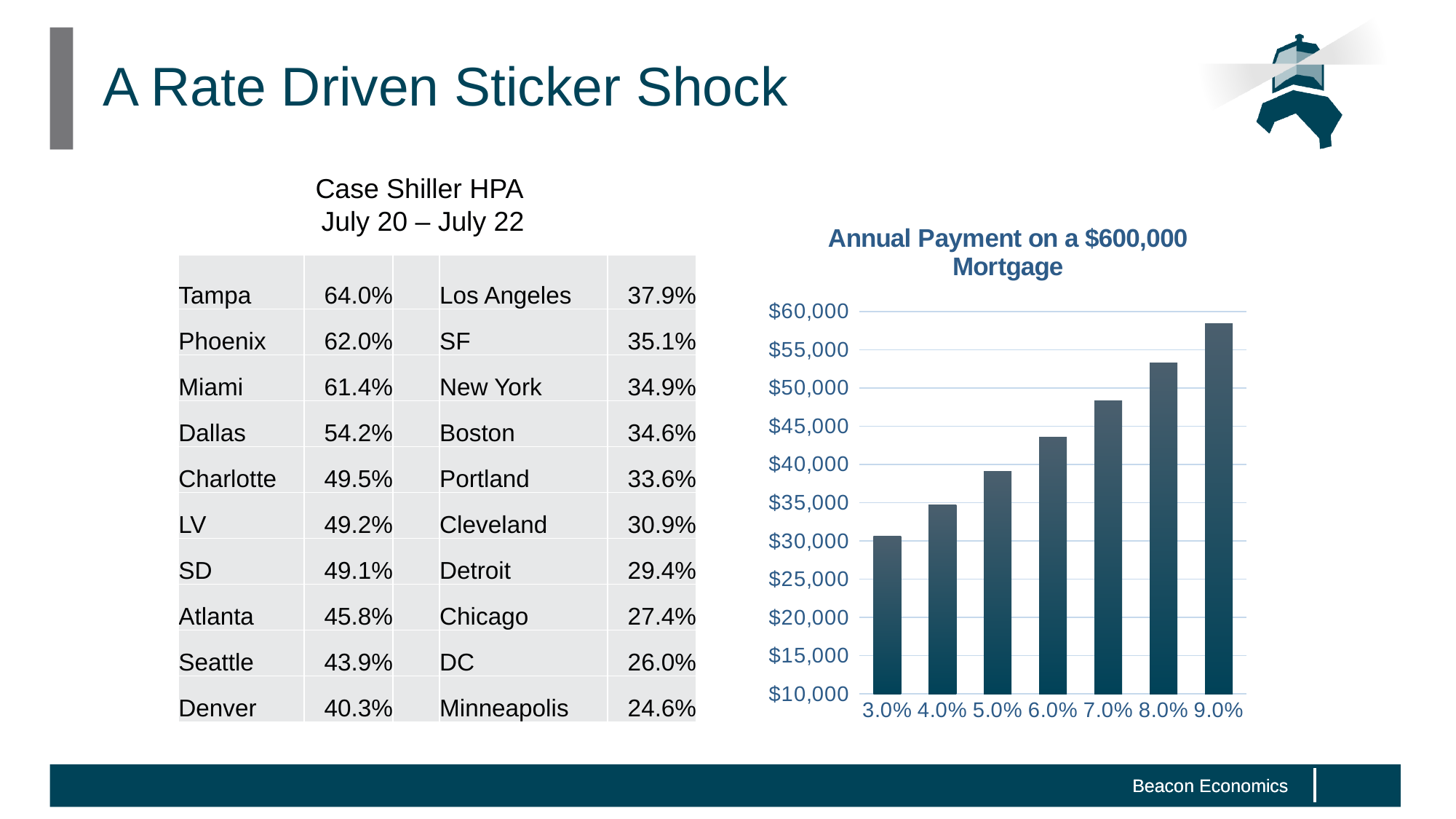
In the Annual Payment on a $600,000 Mortgage chart, which interest rate has the highest annual payment? 9.0% In the Annual Payment on a $600,000 Mortgage chart, do the annual payments rise or fall as the interest rate increases along the x axis? rise In the Annual Payment on a $600,000 Mortgage chart, is the annual payment at 9.0% greater or less than $55,000? greater In the Annual Payment on a $600,000 Mortgage chart, is the annual payment at 8.0% greater or less than $50,000? greater In the Annual Payment on a $600,000 Mortgage chart, which is larger, the annual payment at 5.0% or at 8.0%? 8.0% What is the title of the chart on the slide? Annual Payment on a $600,000 Mortgage What kind of chart is shown on the slide? bar chart In the Annual Payment on a $600,000 Mortgage chart, is the annual payment at 7.0% greater or less than $50,000? less How many bars are plotted in the Annual Payment on a $600,000 Mortgage chart? 7 In the Annual Payment on a $600,000 Mortgage chart, which interest rate has the lowest annual payment? 3.0%